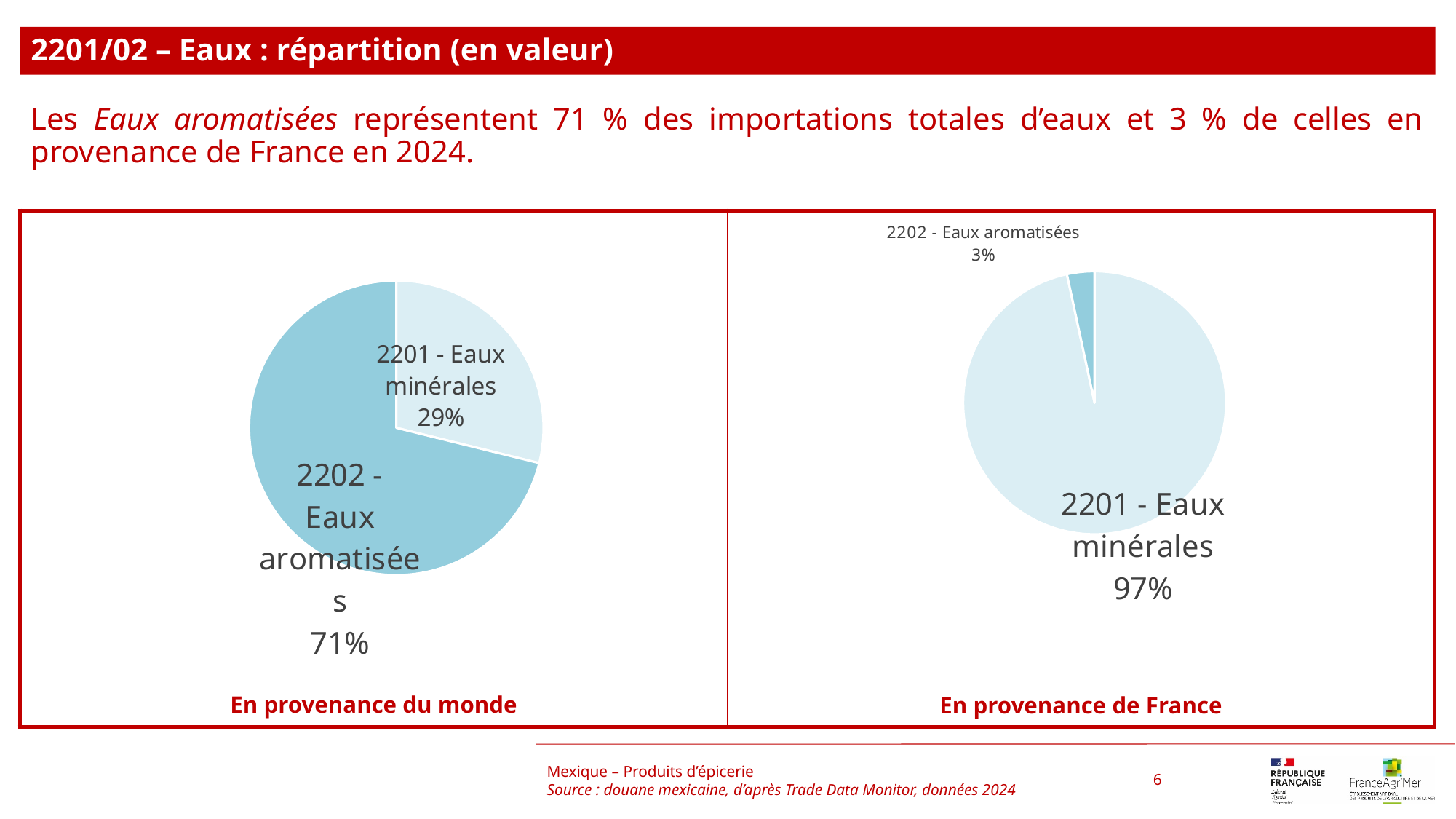
What is the title of the chart on the right side of the slide? En provenance de France In the 'En provenance du monde' chart, what share do 2202 - Eaux aromatisées represent? 71% How many categories does the 'En provenance de France' chart show? 2 In the 'En provenance du monde' chart, what is the difference in percentage points between the 2202 - Eaux aromatisées share and the 2201 - Eaux minérales share? 42 percentage points In the 'En provenance du monde' chart, what share do 2201 - Eaux minérales represent? 29% In the 'En provenance de France' chart, which category has the smallest slice? 2202 - Eaux aromatisées In the 'En provenance de France' chart, what share do 2202 - Eaux aromatisées represent? 3% Which is larger: the share of 2202 - Eaux aromatisées in the 'En provenance du monde' chart or in the 'En provenance de France' chart? En provenance du monde In the 'En provenance du monde' chart, which category has the largest slice? 2202 - Eaux aromatisées What type of chart is the 'En provenance du monde' chart? Pie chart In the 'En provenance de France' chart, what is the difference in percentage points between the 2201 - Eaux minérales share and the 2202 - Eaux aromatisées share? 94 percentage points